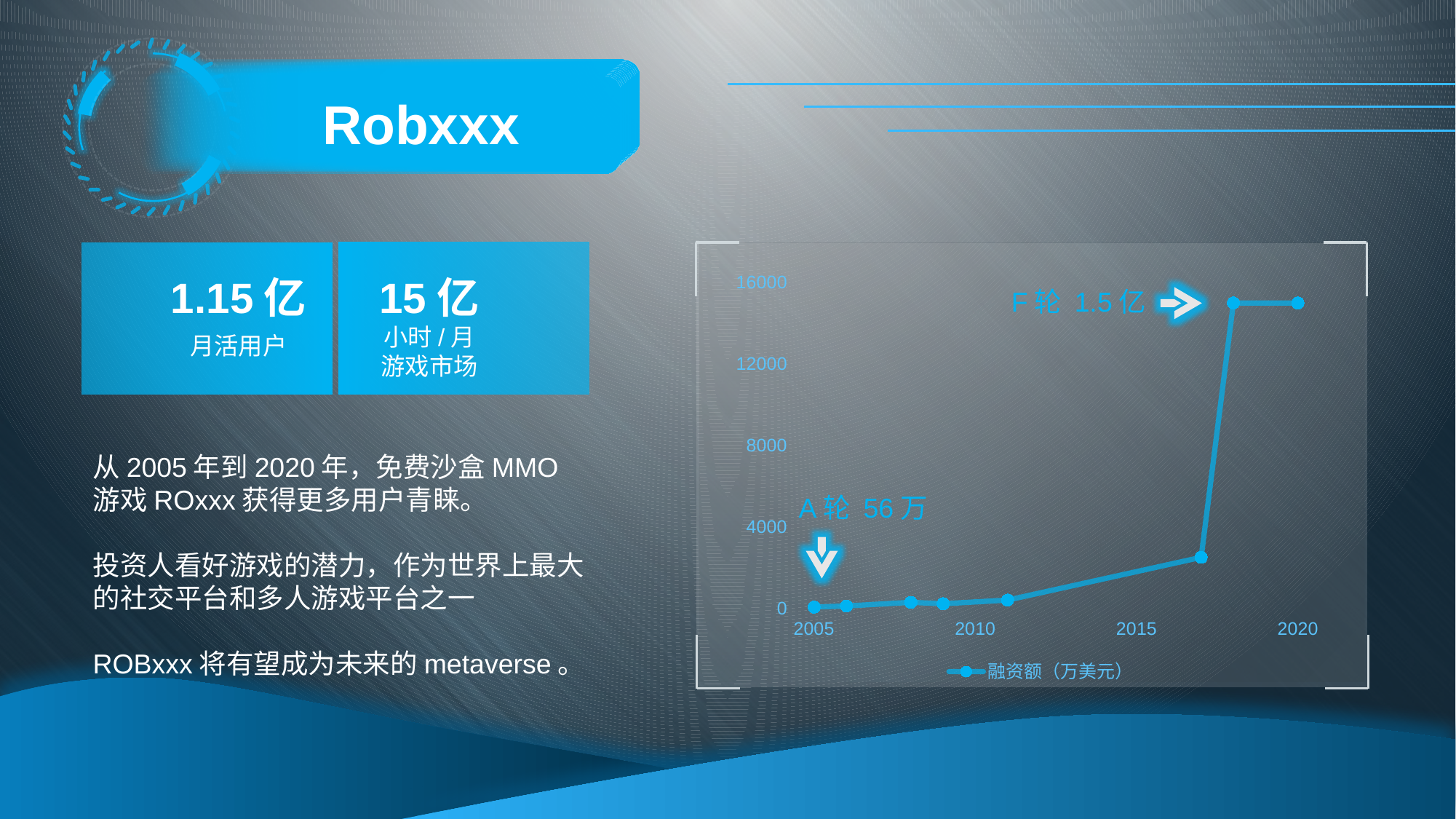
Is the value for 2018 greater or less than 8000? greater Do the values generally rise or fall from 2005 to 2020? rise What is the name of the series shown in the chart legend? 融资额（万美元） What is the highest tick value shown on the vertical axis? 16000 Is the value for 2020 greater or less than 12000? greater Is the value for 2005 greater or less than 4000? less What kind of chart is shown on the slide? line chart How many series does the chart legend list? 1 Which is larger, the value for 2017 or the value for 2011? 2017 How many data points are plotted on the line? 8 Which is larger, the value for 2020 or the value for 2005? 2020